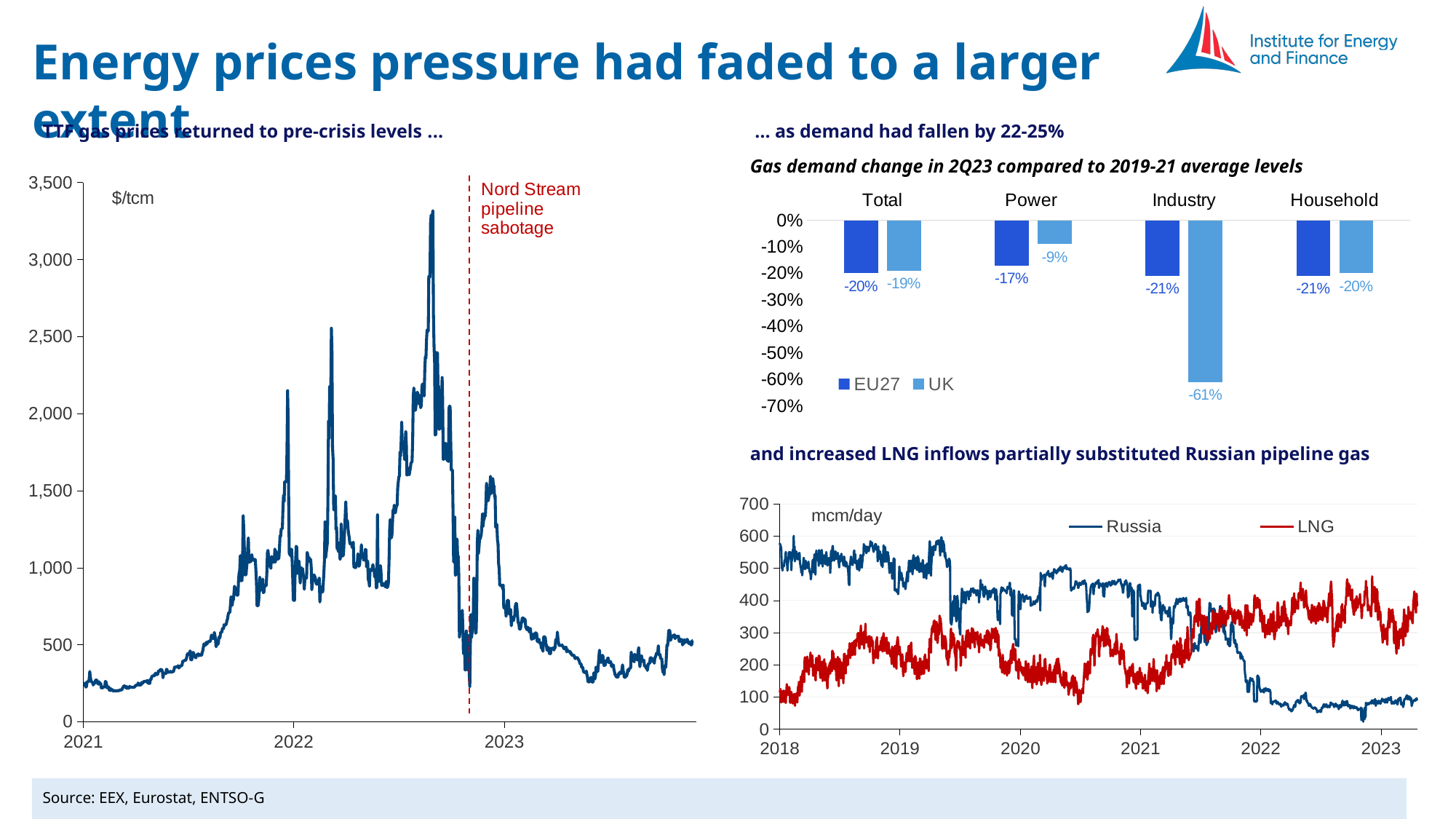
In the bottom-right chart (mcm/day), does the Russia series rise or fall from 2018 to 2023? Fall In the 'Gas demand change in 2Q23 compared to 2019-21 average levels' chart, which bar shows the largest decline? UK Industry (-61%) What unit is shown on the TTF gas prices chart on the left? $/tcm In the 'Gas demand change in 2Q23 compared to 2019-21 average levels' chart, what is the value for EU27 in the Power category? -17% In the 'Gas demand change in 2Q23 compared to 2019-21 average levels' chart, what is the value for the UK in the Industry category? -61% In the 'Gas demand change in 2Q23 compared to 2019-21 average levels' chart, in the Power category, which fell more: EU27 or UK? EU27 In the 'Gas demand change in 2Q23 compared to 2019-21 average levels' chart, what is the difference in percentage points between the EU27 and UK values for Power? 8 percentage points What kind of chart is the 'Gas demand change in 2Q23 compared to 2019-21 average levels' chart? Bar chart In the 'Gas demand change in 2Q23 compared to 2019-21 average levels' chart, how many categories are shown on the x axis? 4 In the 'Gas demand change in 2Q23 compared to 2019-21 average levels' chart, how many series does the legend list? 2 In the bottom-right chart (mcm/day), which series does the legend list? Russia and LNG In the TTF gas prices chart on the left, is the peak value greater or less than 3,000? greater